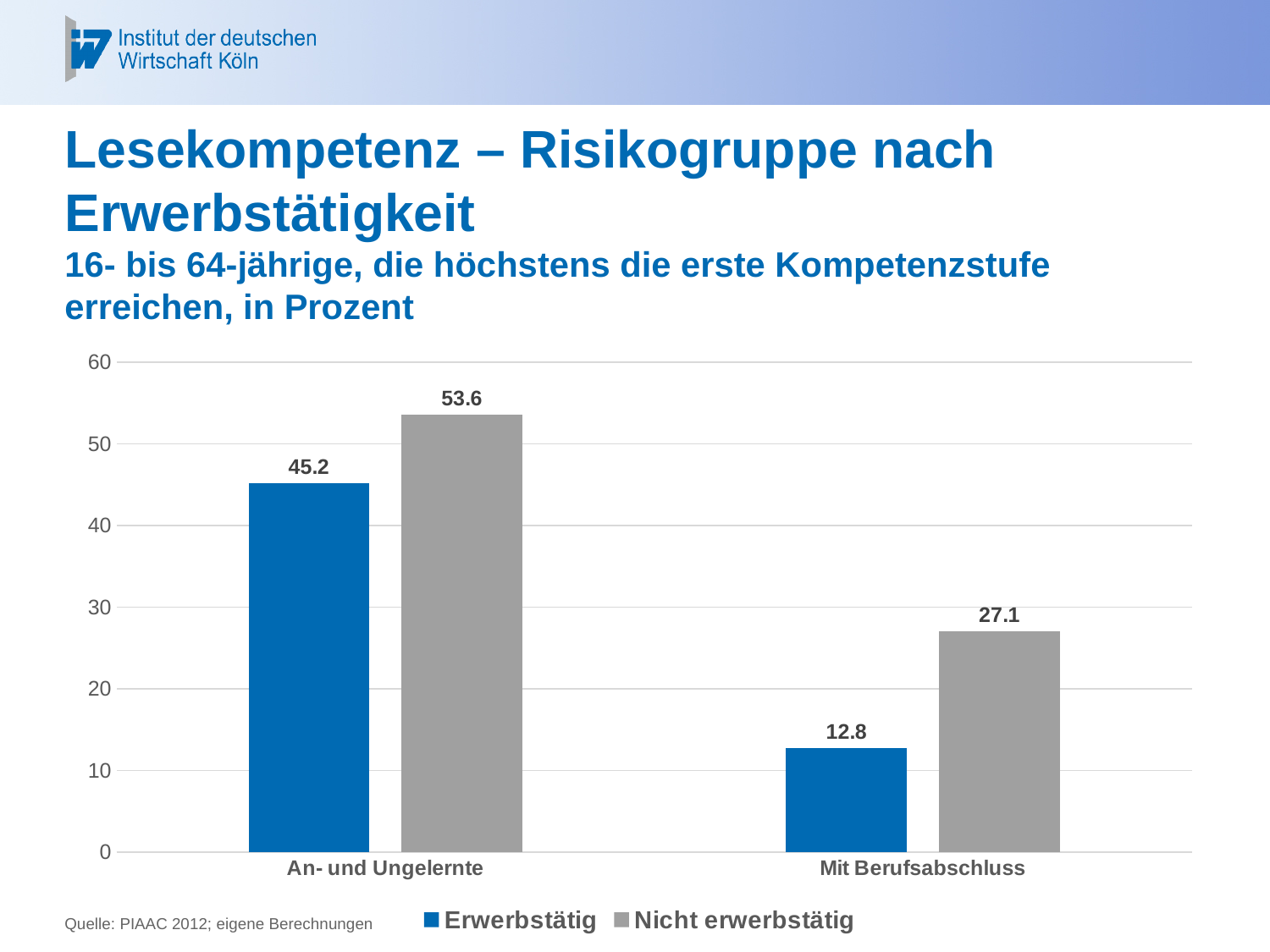
What is the value for Erwerbstätig in the Mit Berufsabschluss category? 12.8 Which is larger: Erwerbstätig for An- und Ungelernte or Nicht erwerbstätig for Mit Berufsabschluss? Erwerbstätig for An- und Ungelernte What is the difference between Nicht erwerbstätig and Erwerbstätig in the Mit Berufsabschluss category? 14.3 Which bar has the lowest value in the chart? Erwerbstätig, Mit Berufsabschluss How many series does the legend list? 2 What kind of chart is shown on the slide? Bar chart What is the value for Nicht erwerbstätig in the Mit Berufsabschluss category? 27.1 How many categories are shown on the x axis? 2 Which bar has the highest value in the chart? Nicht erwerbstätig, An- und Ungelernte What is the value for Nicht erwerbstätig in the An- und Ungelernte category? 53.6 What is the difference between Nicht erwerbstätig and Erwerbstätig in the An- und Ungelernte category? 8.4 What is the value for Erwerbstätig in the An- und Ungelernte category? 45.2